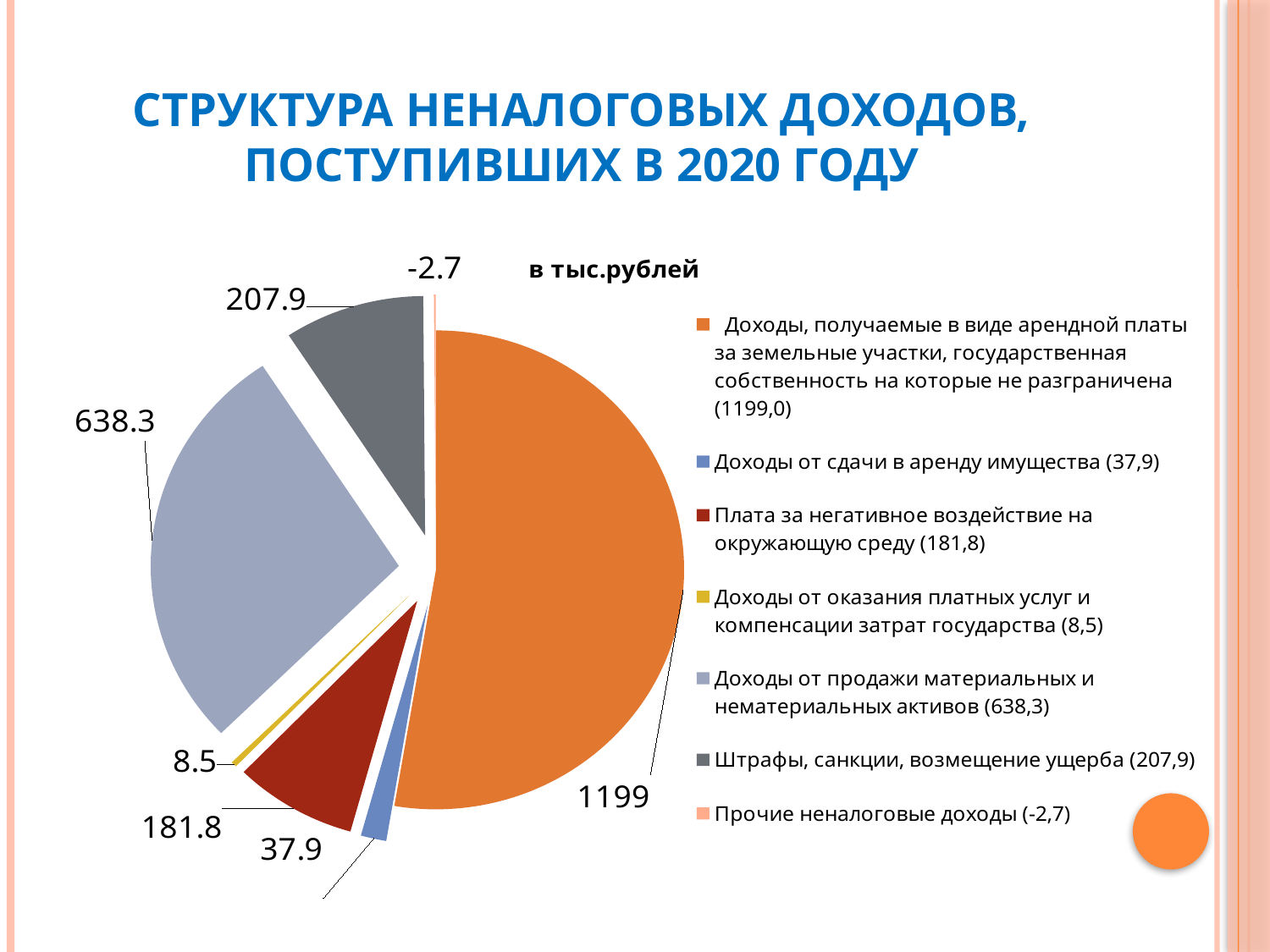
What value is shown for «Доходы от сдачи в аренду имущества»? 37.9 How many slices does the pie chart have? 7 What is the difference between the value for «Доходы, получаемые в виде арендной платы за земельные участки...» (1199) and «Доходы от продажи материальных и нематериальных активов» (638.3)? 560.7 Which is larger: «Штрафы, санкции, возмещение ущерба» or «Плата за негативное воздействие на окружающую среду»? Штрафы, санкции, возмещение ущерба Which category has the smallest value in the pie chart? Прочие неналоговые доходы What is the difference between the values for «Штрафы, санкции, возмещение ущерба» and «Плата за негативное воздействие на окружающую среду»? 26.1 What kind of chart is shown on the slide? pie chart What value is shown for «Плата за негативное воздействие на окружающую среду»? 181.8 What value is shown for «Доходы от продажи материальных и нематериальных активов»? 638.3 Which category has the largest value in the pie chart? Доходы, получаемые в виде арендной платы за земельные участки, государственная собственность на которые не разграничена What value is shown for «Штрафы, санкции, возмещение ущерба»? 207.9 In what units are the values on the chart given, according to the label next to the pie? в тыс.рублей